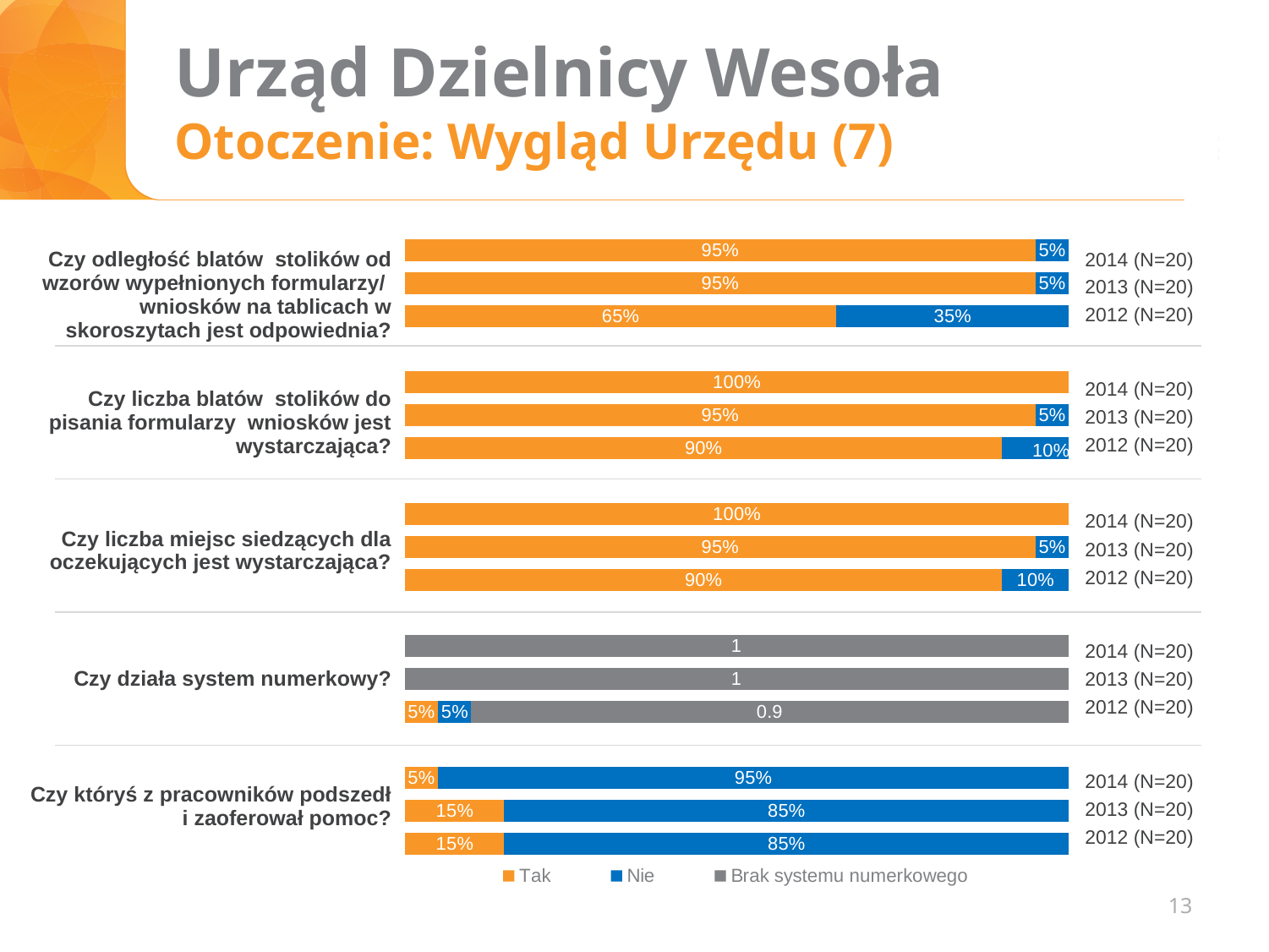
In the chart for "Czy któryś z pracowników podszedł i zaoferował pomoc?", which is larger for 2013 (N=20): "Tak" or "Nie"? Nie In the chart for "Czy liczba miejsc siedzących dla oczekujących jest wystarczająca?", which year has the highest "Tak" value? 2014 (N=20) What kind of chart is used on this slide? stacked bar chart In the chart for "Czy działa system numerkowy?", what is the "Brak systemu numerkowego" value for 2012 (N=20)? 0.9 In the chart for "Czy odległość blatów stolików od wzorów wypełnionych formularzy/wniosków na tablicach w skoroszytach jest odpowiednia?", does the "Tak" value rise or fall from 2012 (N=20) to 2014 (N=20)? rise In the chart for "Czy któryś z pracowników podszedł i zaoferował pomoc?", what is the "Tak" value for 2014 (N=20)? 5% In the chart for "Czy odległość blatów stolików od wzorów wypełnionych formularzy/wniosków na tablicach w skoroszytach jest odpowiednia?", what is the "Nie" value for 2012 (N=20)? 35% In the chart for "Czy liczba blatów stolików do pisania formularzy wniosków jest wystarczająca?", what is the "Nie" value for 2012 (N=20)? 10% In the chart for "Czy liczba blatów stolików do pisania formularzy wniosków jest wystarczająca?", what is the "Tak" value for 2014 (N=20)? 100% In the chart for "Czy odległość blatów stolików od wzorów wypełnionych formularzy/wniosków na tablicach w skoroszytach jest odpowiednia?", what is the "Tak" value for 2012 (N=20)? 65% How many series does the legend at the bottom of the slide list? 3 In the chart for "Czy liczba miejsc siedzących dla oczekujących jest wystarczająca?", what is the difference between the "Tak" values for 2014 (N=20) and 2012 (N=20)? 10%